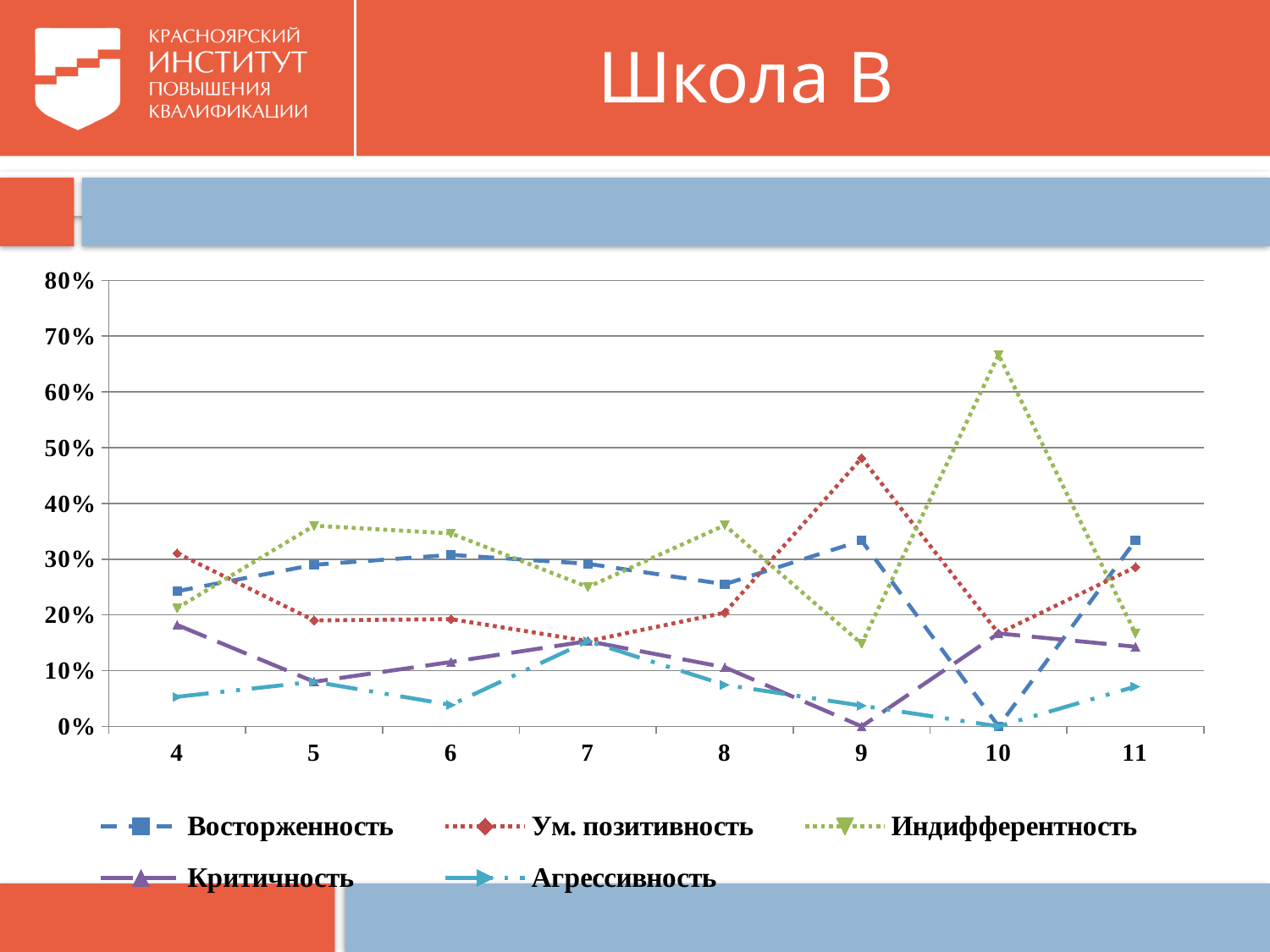
Is the value for Индифферентность at category 10 greater or less than 60%? greater What kind of chart is shown on the slide? line chart How many series does the legend list? 5 Is the value for Агрессивность at category 6 greater or less than 10%? less At which x-axis category does Ум. позитивность reach its highest value? 9 At which x-axis category does Восторженность reach its lowest value? 10 How many categories are shown on the x axis? 8 At category 10, which is larger: Индифферентность or Восторженность? Индифферентность Does the Индифферентность line rise or fall from category 9 to category 10? rise Is the value for Ум. позитивность at category 9 greater or less than 50%? less At which x-axis category does Индифферентность reach its highest value? 10 What is the title of the slide containing the chart? Школа В